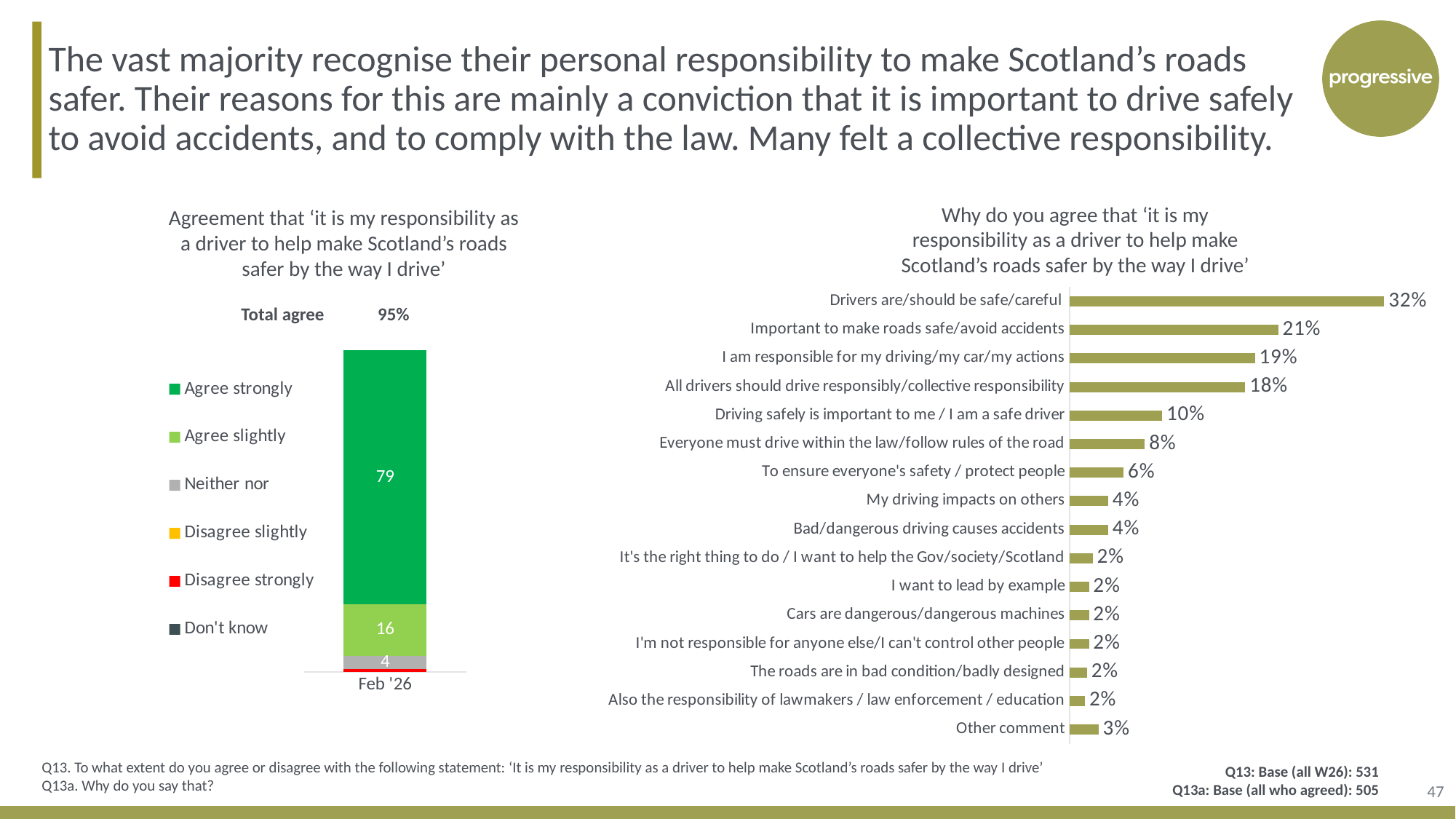
What kind of chart is the 'Why do you agree...' chart on the right? Bar chart In the 'Why do you agree...' chart, what is the value for 'Everyone must drive within the law/follow rules of the road'? 8% In the 'Why do you agree...' chart, which is larger: 'I am responsible for my driving/my car/my actions' or 'Driving safely is important to me / I am a safe driver'? I am responsible for my driving/my car/my actions In the 'Why do you agree...' chart, what is the value for 'Important to make roads safe/avoid accidents'? 21% In the 'Agreement that it is my responsibility as a driver...' chart, how many series does the legend list? 6 In the 'Why do you agree...' chart, which reason has the highest value? Drivers are/should be safe/careful In the 'Agreement that it is my responsibility as a driver...' chart, what is the value for Agree strongly in Feb '26? 79 In the 'Why do you agree...' chart, how many reasons (categories) are plotted? 16 In the 'Agreement that it is my responsibility as a driver...' chart, what is the difference between Agree strongly and Agree slightly? 63 In the 'Why do you agree...' chart, what is the difference between 'Drivers are/should be safe/careful' and 'All drivers should drive responsibly/collective responsibility'? 14% In the 'Agreement that it is my responsibility as a driver...' chart, what is the value for Agree slightly? 16 In the 'Agreement that it is my responsibility as a driver...' chart, what is the Total agree figure shown? 95%